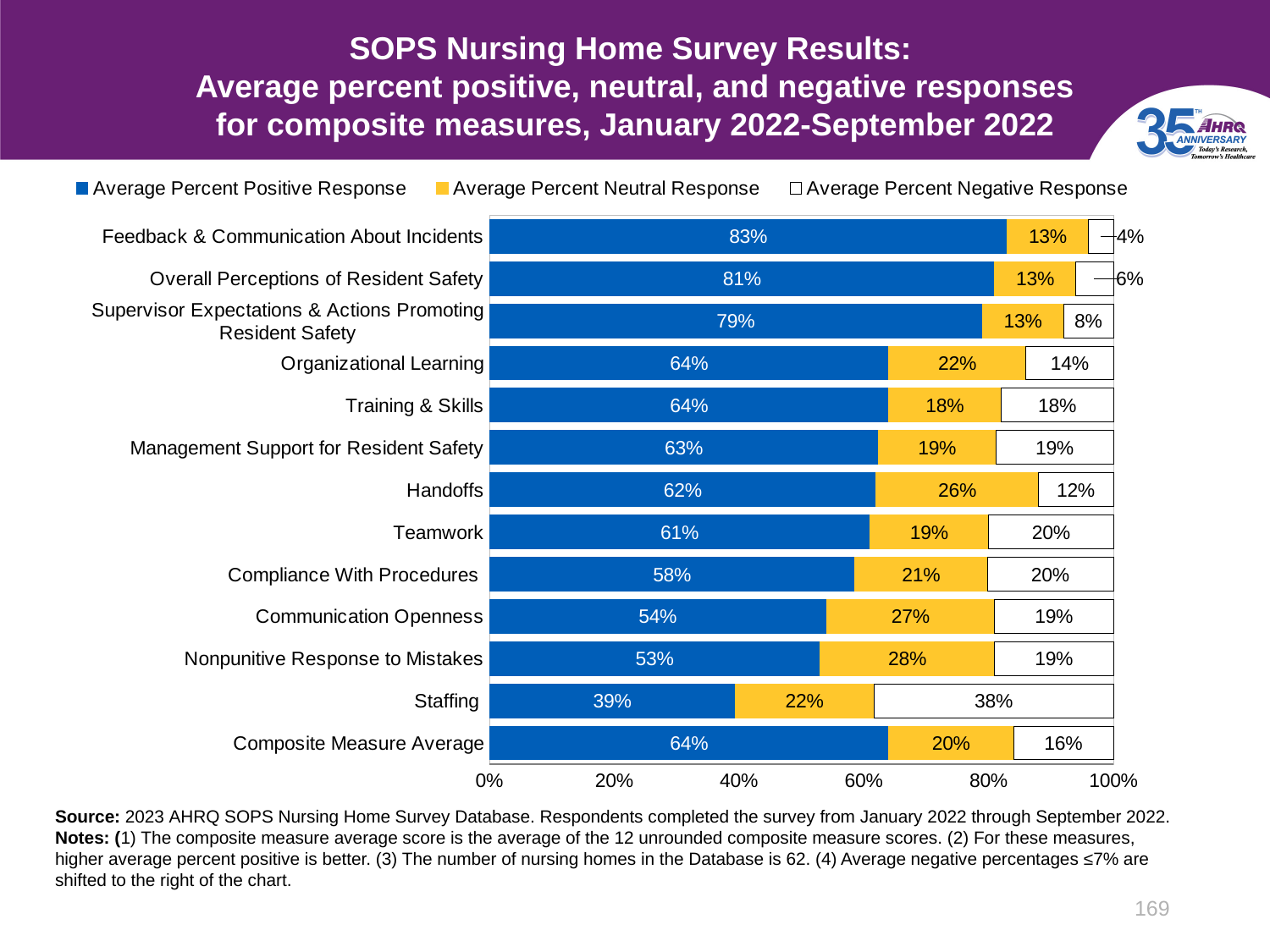
How many composite measure categories are shown on the chart, including the Composite Measure Average? 13 Which colour represents the Average Percent Neutral Response in the chart? Yellow What is the Average Percent Negative Response for Staffing? 38% What is the difference between the Average Percent Positive Response for Organizational Learning and for Staffing? 25% What is the Average Percent Positive Response for the Composite Measure Average? 64% What is the Average Percent Neutral Response for Nonpunitive Response to Mistakes? 28% What is the Average Percent Positive Response for Handoffs? 62% Which has a larger Average Percent Neutral Response, Communication Openness or Teamwork? Communication Openness Which composite measure has the highest Average Percent Positive Response? Feedback & Communication About Incidents What kind of chart is shown on the slide? Stacked bar chart Which composite measure has the lowest Average Percent Positive Response? Staffing How many series does the legend list? 3